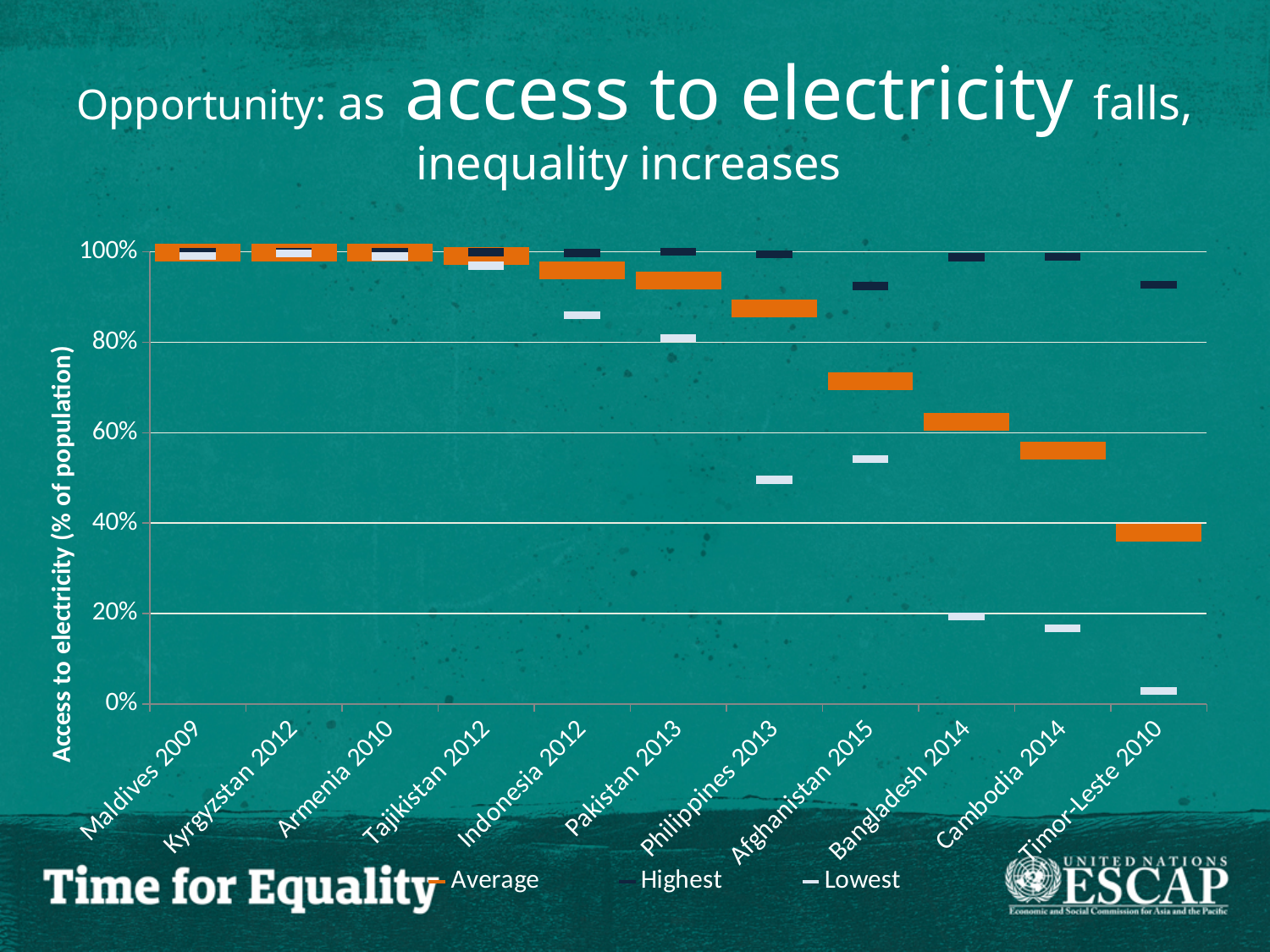
Which is larger, the Average value for Afghanistan 2015 or the Average value for Cambodia 2014? Afghanistan 2015 What kind of chart is shown on the slide? line chart How many countries are shown on the x axis of the chart? 11 Do the Average values rise or fall moving from left to right along the x axis? fall Is the Average value for Cambodia 2014 greater or less than 60%? less Is the Lowest value for Philippines 2013 greater or less than 60%? less Is the Average value for Afghanistan 2015 greater or less than 80%? less How many series does the chart legend list? 3 Which country has the lowest Average access to electricity? Timor-Leste 2010 Which country has the lowest value for the Lowest series? Timor-Leste 2010